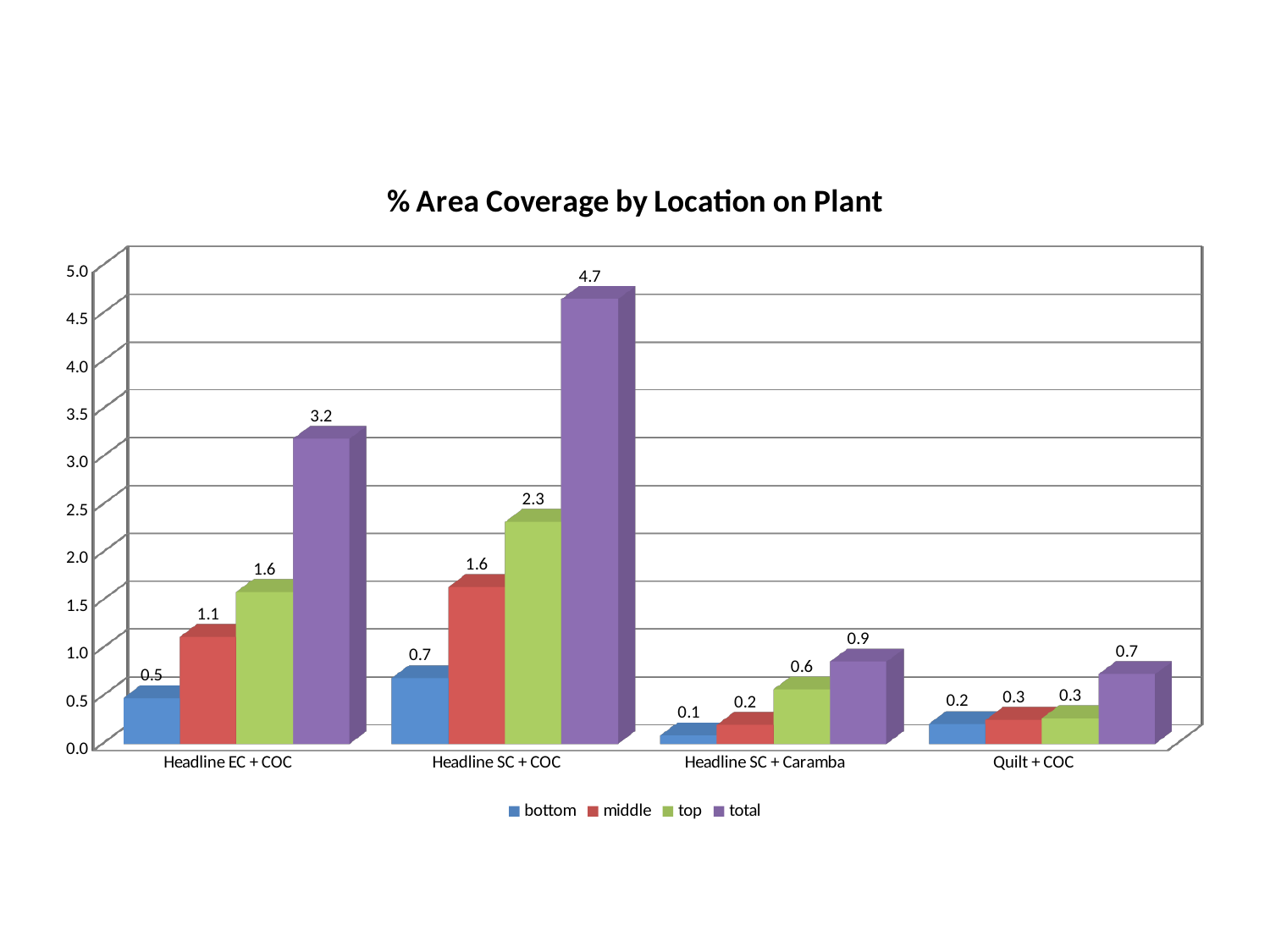
Which category has the highest total value? Headline SC + COC Which is larger, the top value for Headline SC + COC or the top value for Headline EC + COC? Headline SC + COC What is the bottom value for Quilt + COC? 0.2 What is the difference between the total values for Headline SC + COC and Headline EC + COC? 1.5 How many series does the legend list? 4 What is the title of the chart? % Area Coverage by Location on Plant Which category has the lowest bottom value? Headline SC + Caramba What is the middle value for Headline EC + COC? 1.1 What is the top value for Headline SC + Caramba? 0.6 How many categories are shown on the x axis? 4 What is the total value for Headline SC + COC? 4.7 What kind of chart is shown? bar chart